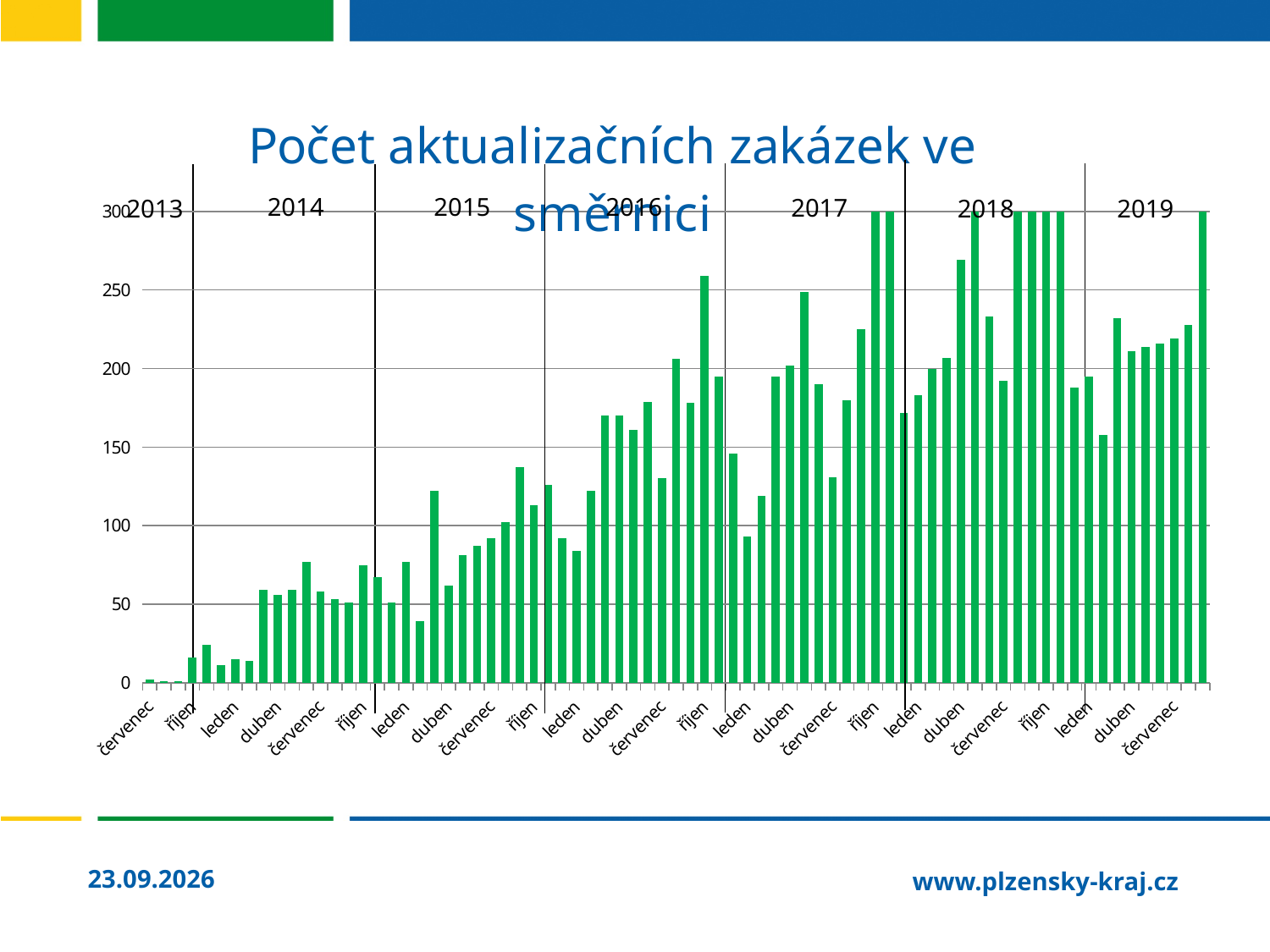
Is the value for červenec 2014 greater or less than 50? greater What kind of chart is shown on the slide? bar chart Do the values generally rise or fall from 2013 to 2019 along the x axis? rise Is the value for duben 2017 greater or less than 150? greater Is the value for červenec 2013 greater or less than 50? less What colour are the bars in the chart? green What is the title of the chart? Počet aktualizačních zakázek ve směrnici How many year labels (2013 to 2019) are shown across the top of the chart? 7